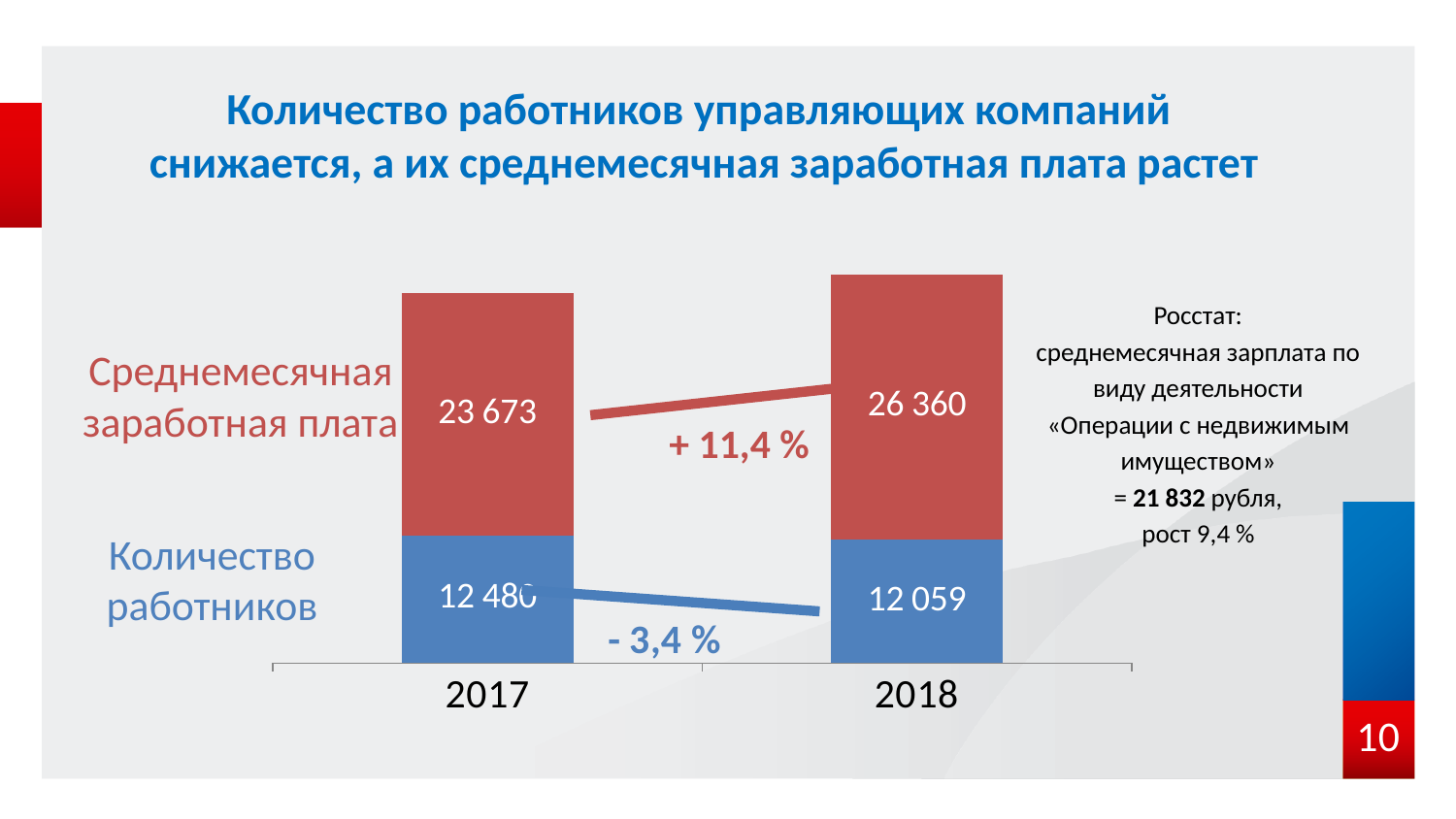
Which year has the higher average monthly salary, 2017 or 2018? 2018 How many years (categories) are shown on the x axis? 2 What kind of chart is shown on the slide? stacked bar chart What is the average monthly salary (Среднемесячная заработная плата) shown for 2017? 23 673 What is the number of employees (Количество работников) shown for 2018? 12 059 By how much did the average monthly salary increase from 2017 to 2018, based on the labelled values? 2 687 By how much did the number of employees decrease from 2017 to 2018, based on the labelled values? 421 What is the number of employees (Количество работников) shown for 2017? 12 480 What is the average monthly salary (Среднемесячная заработная плата) shown for 2018? 26 360 What percentage change is labelled for the average monthly salary between 2017 and 2018? + 11,4 % Does the number of employees rise or fall from 2017 to 2018? fall How many data series are plotted in the chart? 2